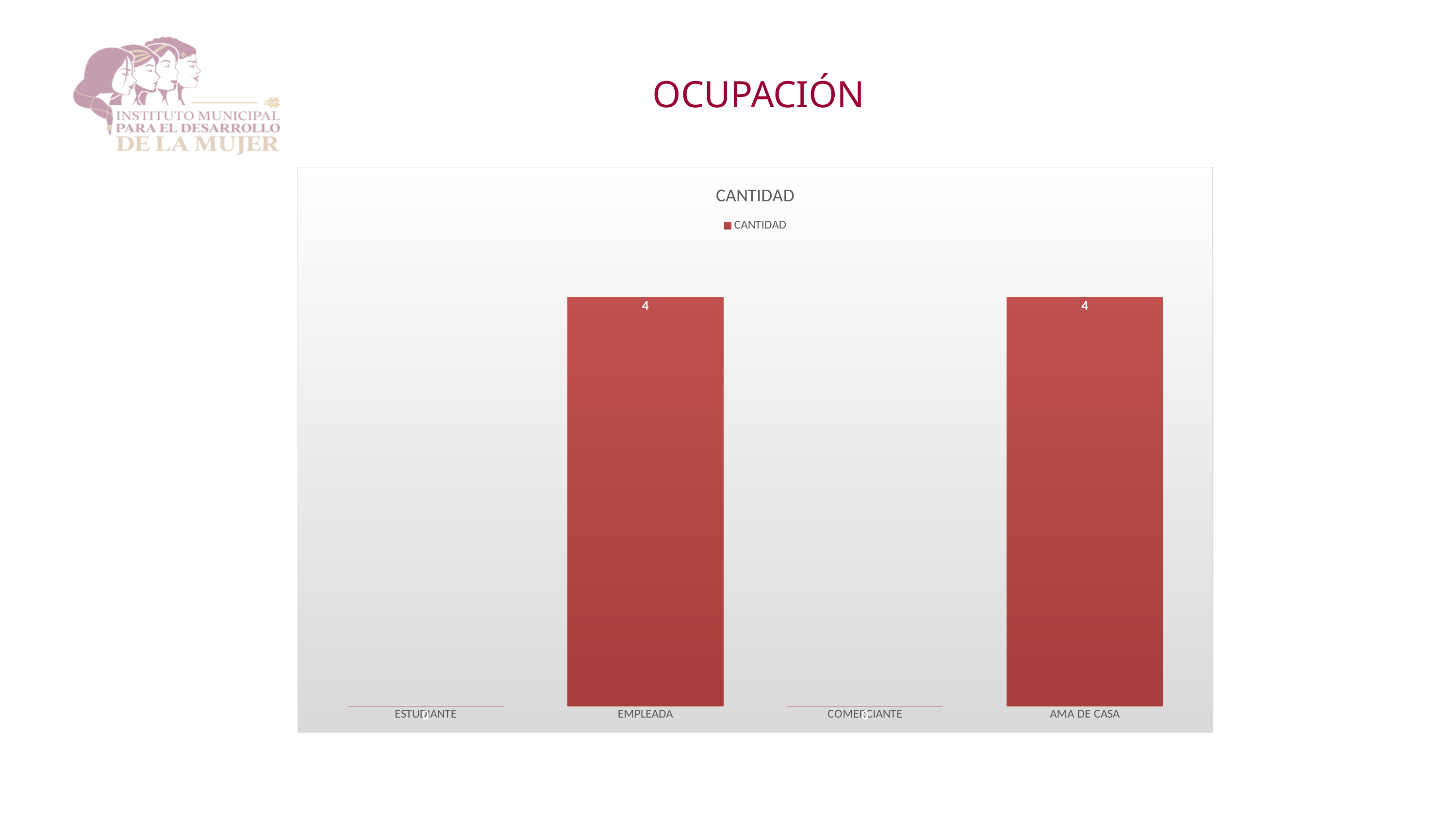
What is the value for COMERCIANTE? 0 What is the value for AMA DE CASA? 4 What is the title of the chart? CANTIDAD What is the difference between the value for EMPLEADA and the value for COMERCIANTE? 4 How many categories are shown on the x axis? 4 How many series does the legend list? 1 Which is larger, the value for COMERCIANTE or the value for AMA DE CASA? AMA DE CASA What is the name of the series listed in the legend? CANTIDAD Which is larger, the value for EMPLEADA or the value for ESTUDIANTE? EMPLEADA What kind of chart is shown on the slide? Bar chart What is the value for ESTUDIANTE? 0 What is the value for EMPLEADA? 4